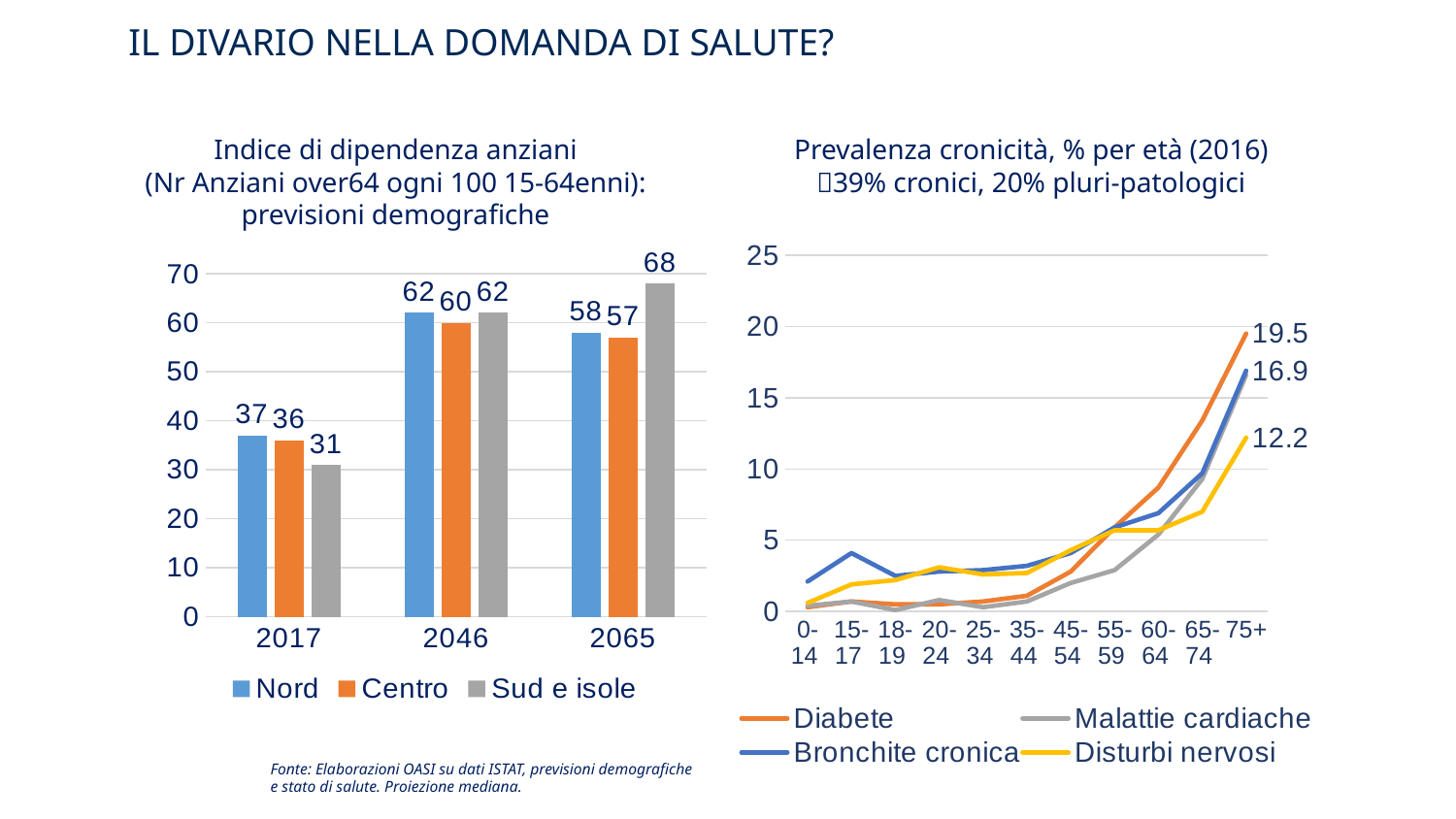
In the right chart (Prevalenza cronicità), what is the value for Diabete in the 75+ age group? 19.5 In the left chart (Indice di dipendenza anziani), which region has the lowest value in 2017? Sud e isole In the left chart (Indice di dipendenza anziani), is the value for Nord in 2046 larger or smaller than the value for Nord in 2065? larger In the left chart (Indice di dipendenza anziani), what is the difference between Sud e isole and Centro in 2065? 11 In the left chart (Indice di dipendenza anziani), what is the value for Nord in 2017? 37 In the right chart (Prevalenza cronicità), is the value for Diabete in the 0-14 age group greater or less than 5? less In the right chart (Prevalenza cronicità), what is the value for Disturbi nervosi in the 75+ age group? 12.2 In the right chart (Prevalenza cronicità), which series has the highest value in the 75+ age group? Diabete What kind of chart is the left chart (Indice di dipendenza anziani)? bar chart In the right chart (Prevalenza cronicità), how many age groups are shown on the x axis? 11 In the left chart (Indice di dipendenza anziani), how many series does the legend list? 3 In the left chart (Indice di dipendenza anziani), what is the value for Sud e isole in 2065? 68